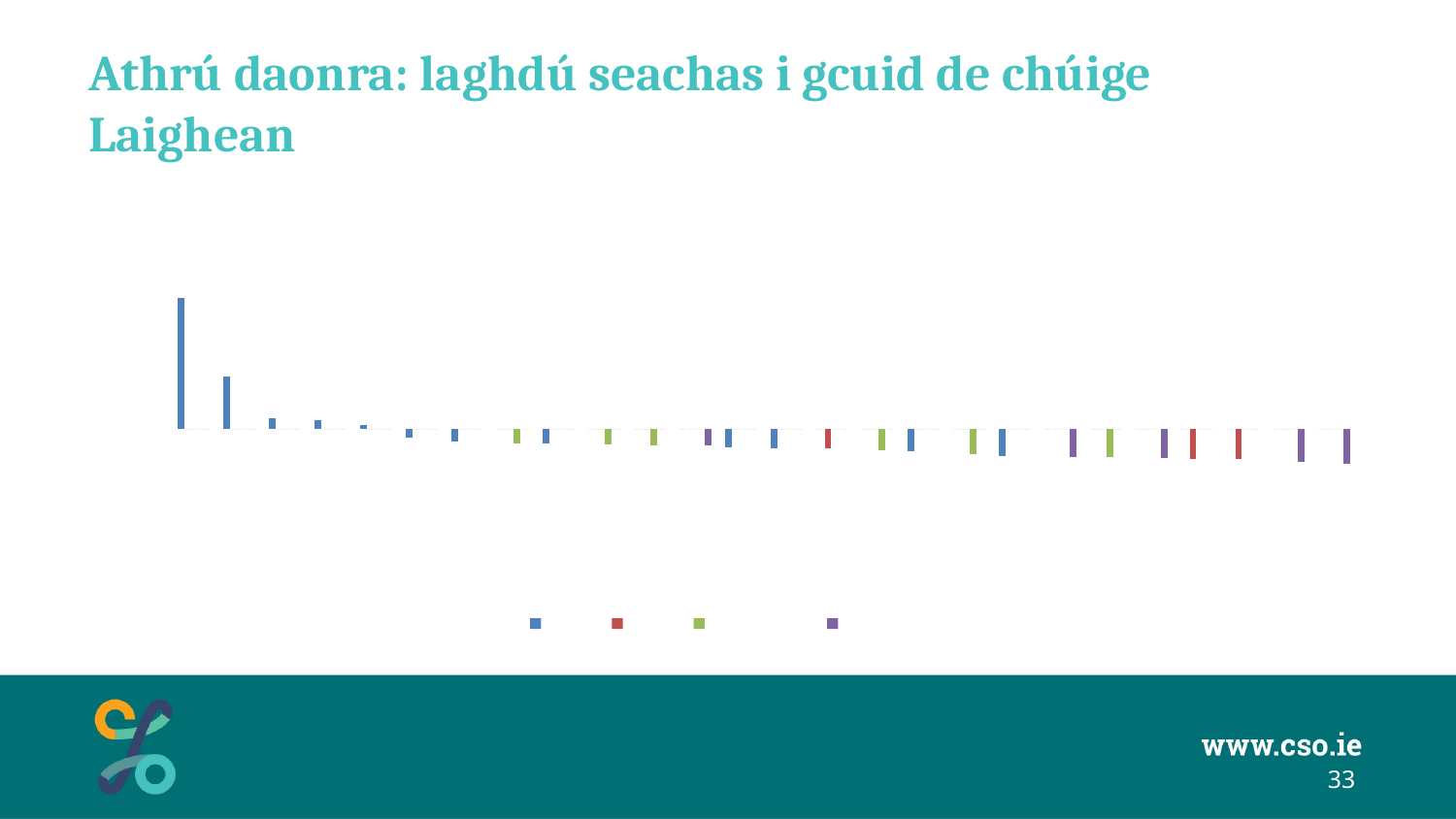
Are the bars on the left side of the chart above or below the baseline? above Do the bar values rise or fall moving from left to right along the x axis? fall How many series does the chart's legend list? 4 What kind of chart is shown on the slide? bar chart Are the bars on the right side of the chart above or below the baseline? below